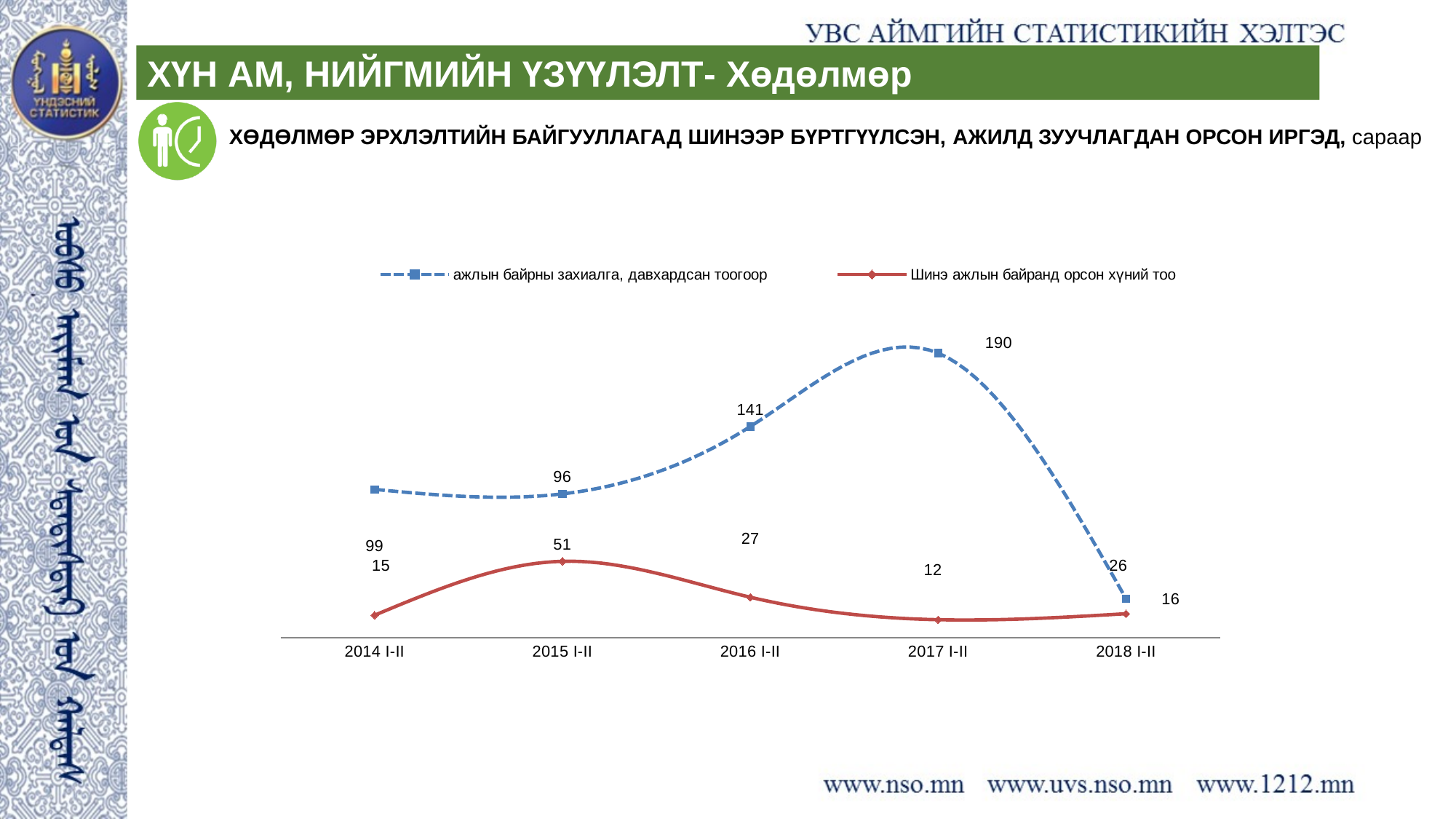
Which is larger in 2018 I-II: 'ажлын байрны захиалга, давхардсан тоогоор' or 'Шинэ ажлын байранд орсон хүний тоо'? ажлын байрны захиалга, давхардсан тоогоор How many periods are shown on the x axis? 5 What is the value of 'Шинэ ажлын байранд орсон хүний тоо' for 2015 I-II? 51 Which series is drawn with a dashed line? ажлын байрны захиалга, давхардсан тоогоор Does 'ажлын байрны захиалга, давхардсан тоогоор' rise or fall from 2017 I-II to 2018 I-II? fall In which period is 'ажлын байрны захиалга, давхардсан тоогоор' highest? 2017 I-II In which period is 'Шинэ ажлын байранд орсон хүний тоо' lowest? 2017 I-II What type of chart is shown on the slide? line chart What is the value of 'ажлын байрны захиалга, давхардсан тоогоор' for 2017 I-II? 190 What is the value of 'ажлын байрны захиалга, давхардсан тоогоор' for 2018 I-II? 26 What is the difference between 'ажлын байрны захиалга, давхардсан тоогоор' and 'Шинэ ажлын байранд орсон хүний тоо' in 2016 I-II? 114 How many series does the legend list? 2